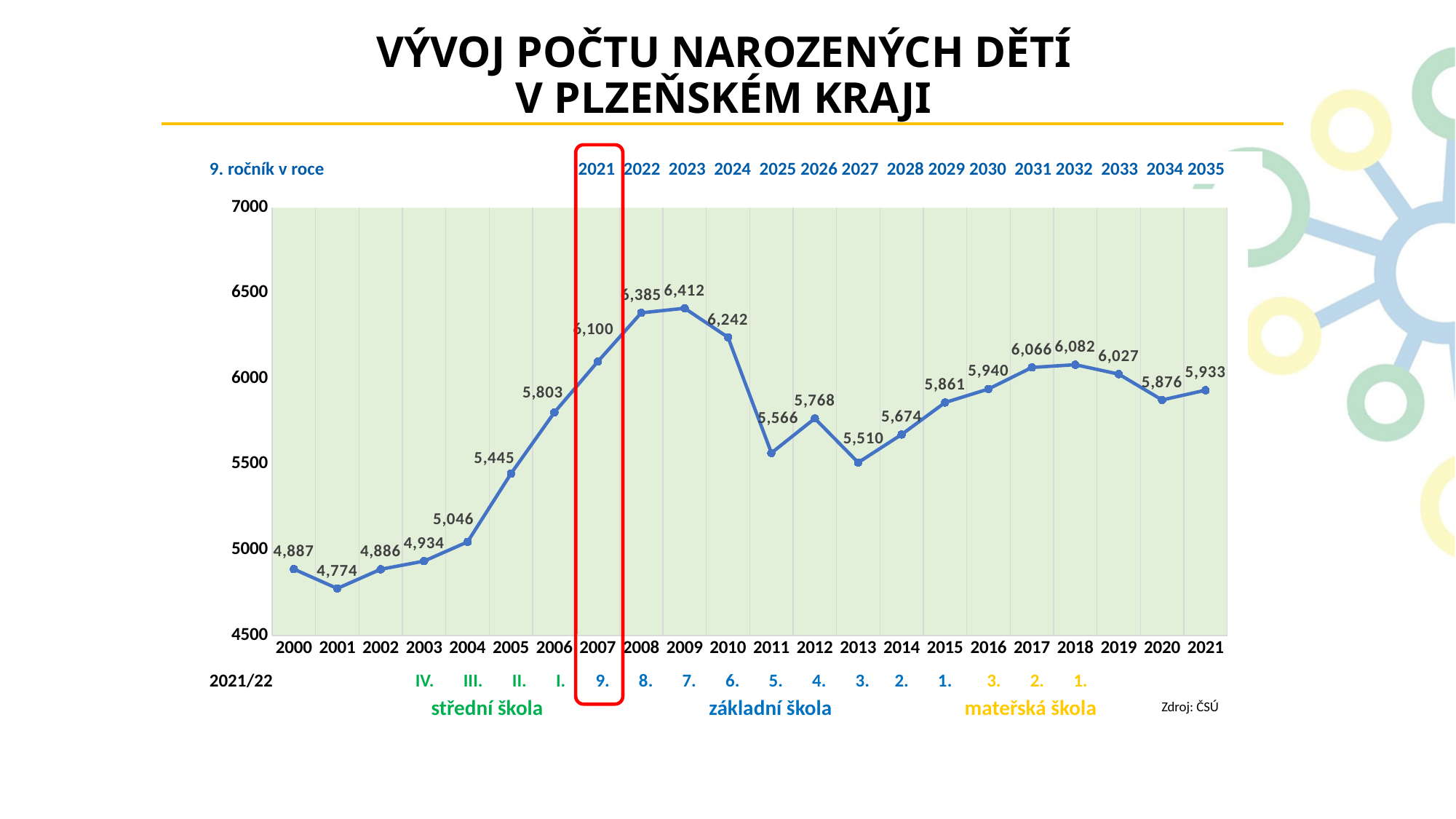
What type of chart is shown on the slide? line chart Which year has a larger value, 2012 or 2014? 2012 Is the value for 2005 greater or less than 5500? less What is the difference between the values for 2009 and 2001? 1,638 What is the value plotted for 2021? 5,933 How many years are plotted on the x axis? 22 Do the values rise or fall from 2001 to 2009? rise What is the number of children born in 2007? 6,100 Which year has the highest number of children born? 2009 What is the value plotted for 2013? 5,510 What is the difference between the values for 2021 and 2020? 57 Which year has the lowest number of children born? 2001